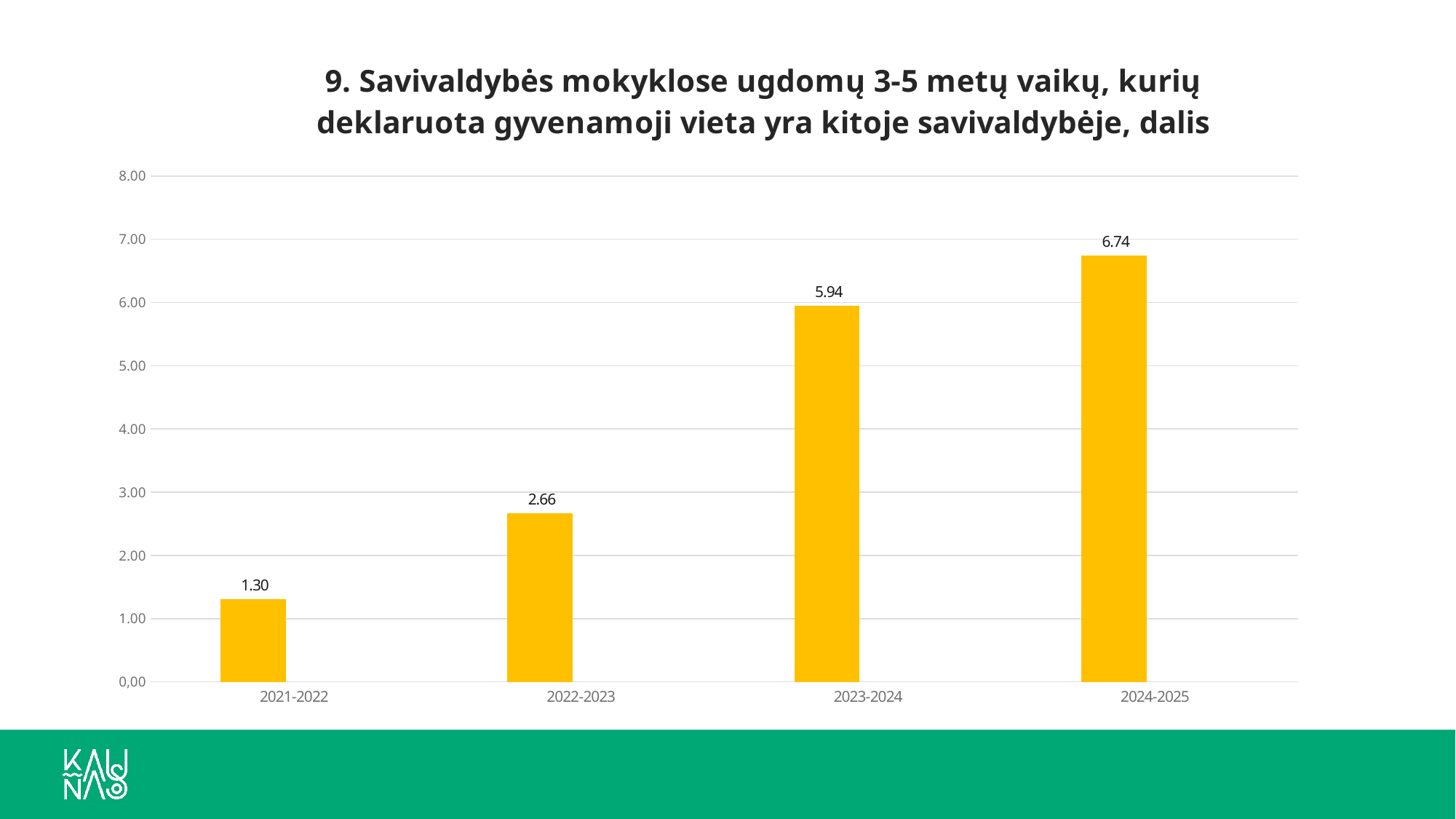
What is the difference between the values for 2024-2025 and 2023-2024? 0.80 What is the value for 2022-2023? 2.66 Is the value for 2023-2024 greater or less than 5.00? greater Which school year has the lowest value? 2021-2022 Which is larger, the value for 2022-2023 or the value for 2023-2024? 2023-2024 Which school year has the highest value? 2024-2025 What is the value for 2021-2022? 1.30 What is the difference between the values for 2022-2023 and 2021-2022? 1.36 What is the value for 2024-2025? 6.74 How many school years are shown on the x axis? 4 What is the value for 2023-2024? 5.94 Do the values rise or fall from 2021-2022 to 2024-2025? rise